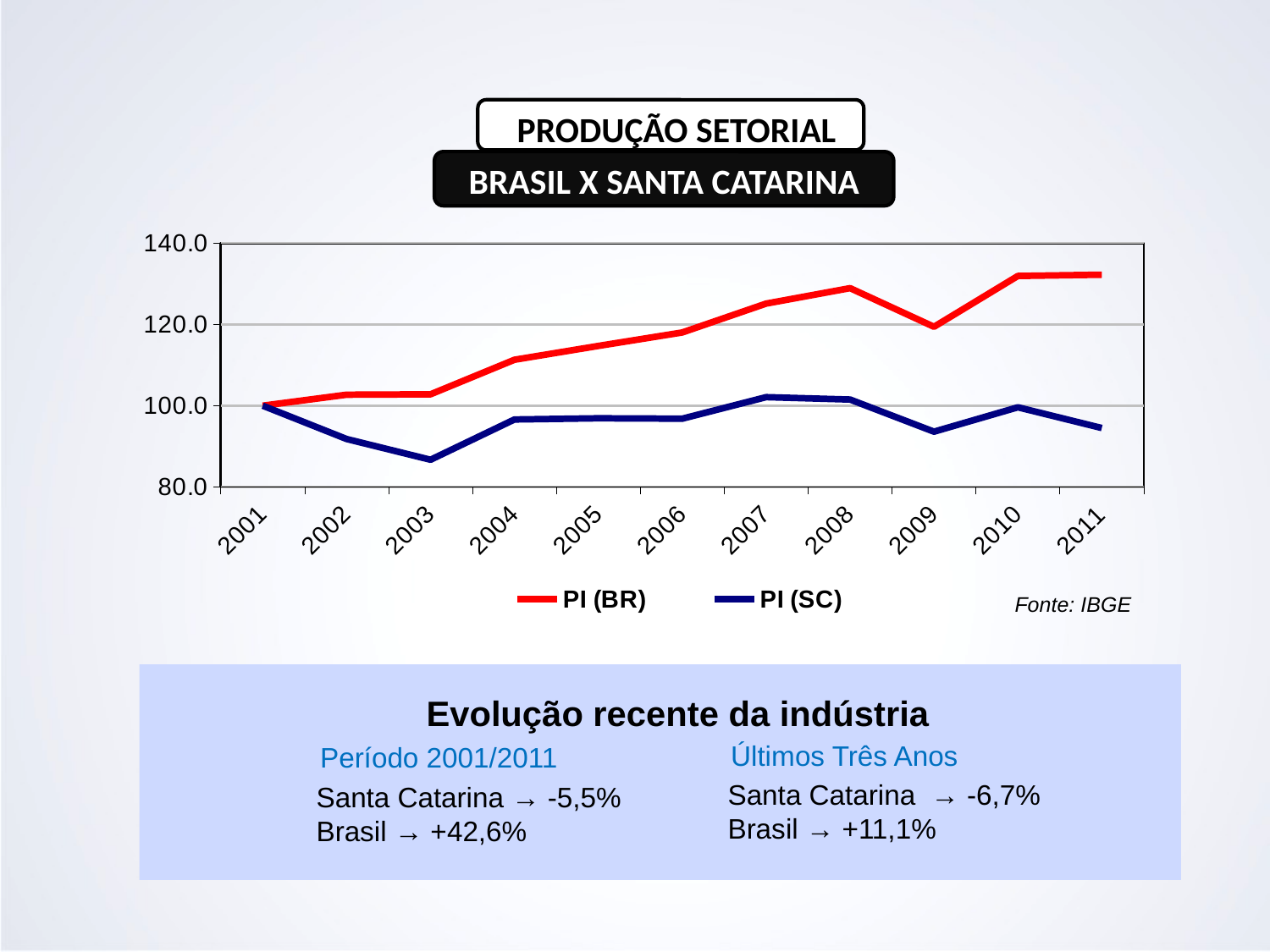
Is the value for PI (BR) in 2011 greater or less than 120? greater Is the value for PI (SC) in 2003 greater or less than 100? less Does PI (BR) rise or fall overall from 2001 to 2011? rise Is the value for PI (SC) in 2009 greater or less than 100? less How many years are plotted along the x axis of the chart? 11 What colour is the PI (BR) line in the chart? red What is the value of PI (SC) in 2001? 100.0 How many series does the chart legend list? 2 What kind of chart is shown on the slide? line chart In 2011, which series has the larger value, PI (BR) or PI (SC)? PI (BR) In which year is PI (SC) at its lowest? 2003 What is the value of PI (BR) in 2001? 100.0